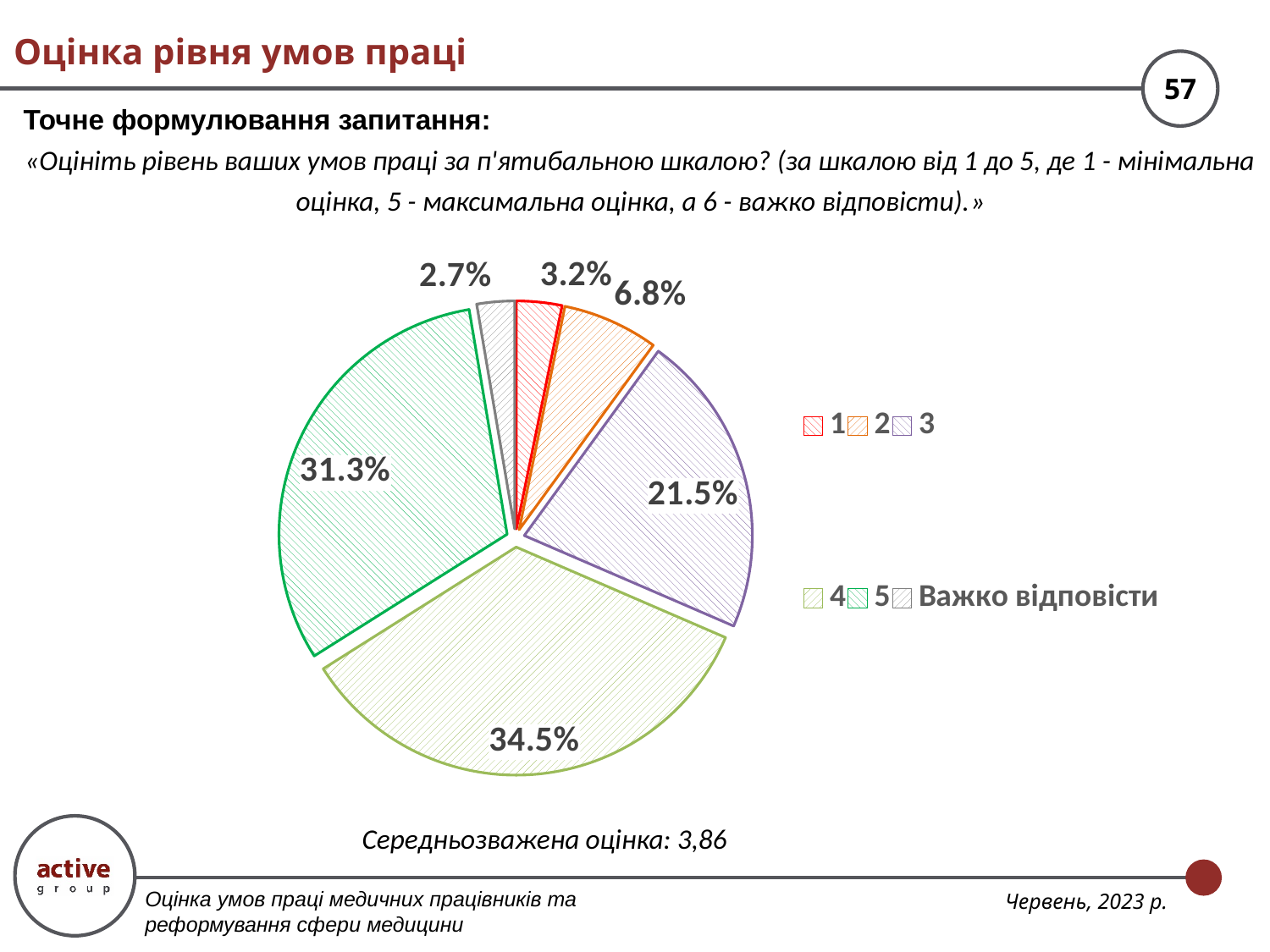
How many categories does the pie chart have? 6 What share of respondents gave a rating of 4? 34.5% What type of chart is shown on the slide? pie chart What share of respondents gave a rating of 1? 3.2% What is the weighted average score stated below the chart? 3,86 What share of respondents gave a rating of 5? 31.3% Which category has the smallest slice of the pie? Важко відповісти Which category has the largest slice of the pie? 4 What share of respondents gave a rating of 3? 21.5% What is the difference in percentage points between the shares for ratings 4 and 5? 3.2 Which is larger, the share for rating 2 or the share for rating 3? 3 What share of respondents answered 'Важко відповісти'? 2.7%